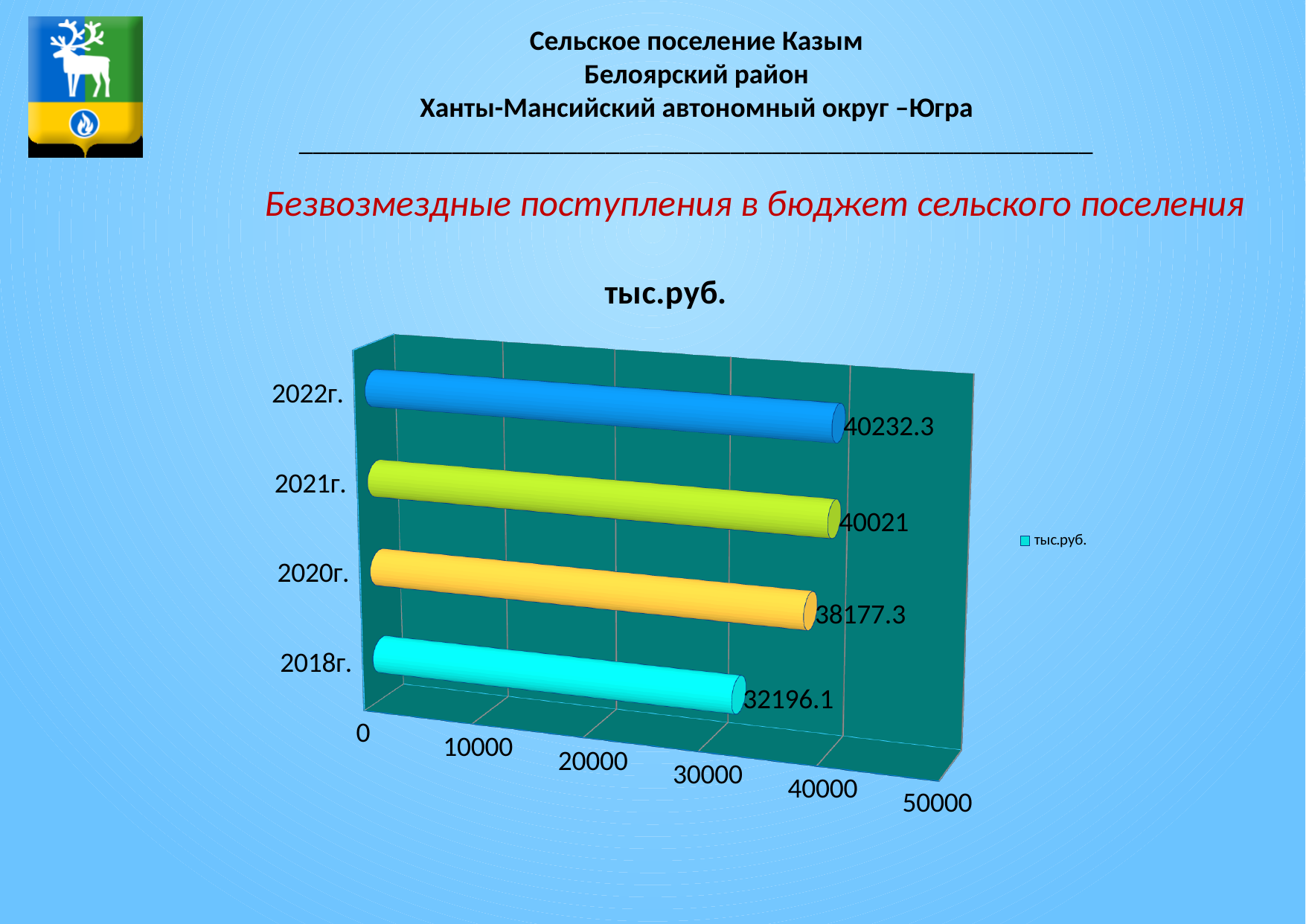
What is the value for 2021г.? 40021 What is the difference between the values for 2022г. and 2018г.? 8036.2 What is the value for 2018г.? 32196.1 What is the value for 2022г.? 40232.3 What kind of chart is shown on the slide? bar chart Which year has the lowest value? 2018г. Which is larger, the value for 2020г. or the value for 2018г.? 2020г. What is the difference between the values for 2021г. and 2020г.? 1843.7 What is the value for 2020г.? 38177.3 How many years are shown in the chart? 4 What is the title of the chart? тыс.руб. Which year has the highest value? 2022г.